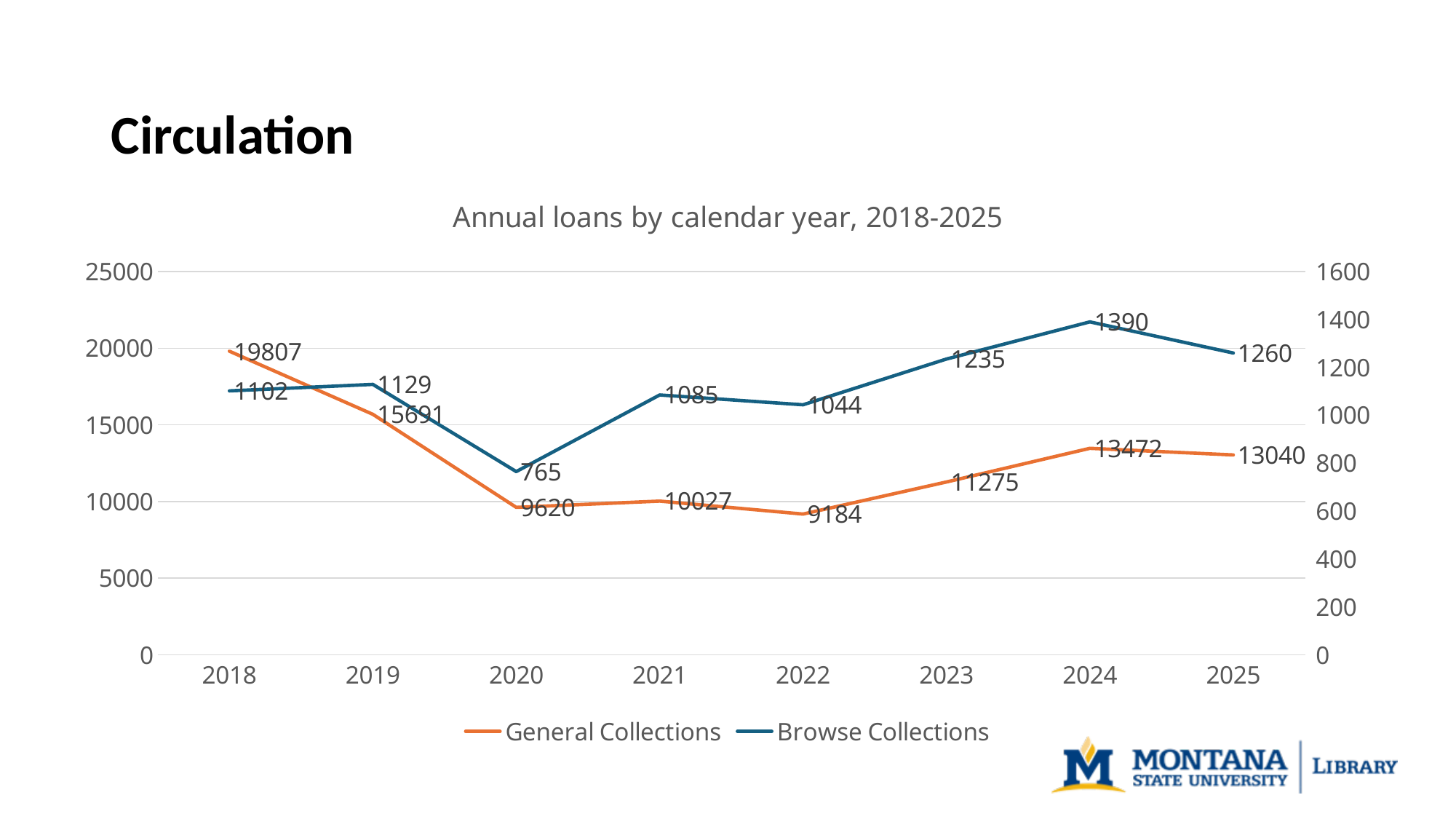
What is the Browse Collections value for 2024? 1390 In which year is the Browse Collections value lowest? 2020 How many series does the legend list? 2 What is the General Collections value for 2022? 9184 What is the difference between the General Collections values for 2024 and 2025? 432 What is the General Collections value for 2018? 19807 Does the General Collections line rise or fall from 2018 to 2020? Fall How many years are plotted on the x axis? 8 What is the title of the chart? Annual loans by calendar year, 2018-2025 Which is larger, the Browse Collections value for 2019 or for 2021? 2019 In which year is the General Collections value highest? 2018 What kind of chart is shown? Line chart